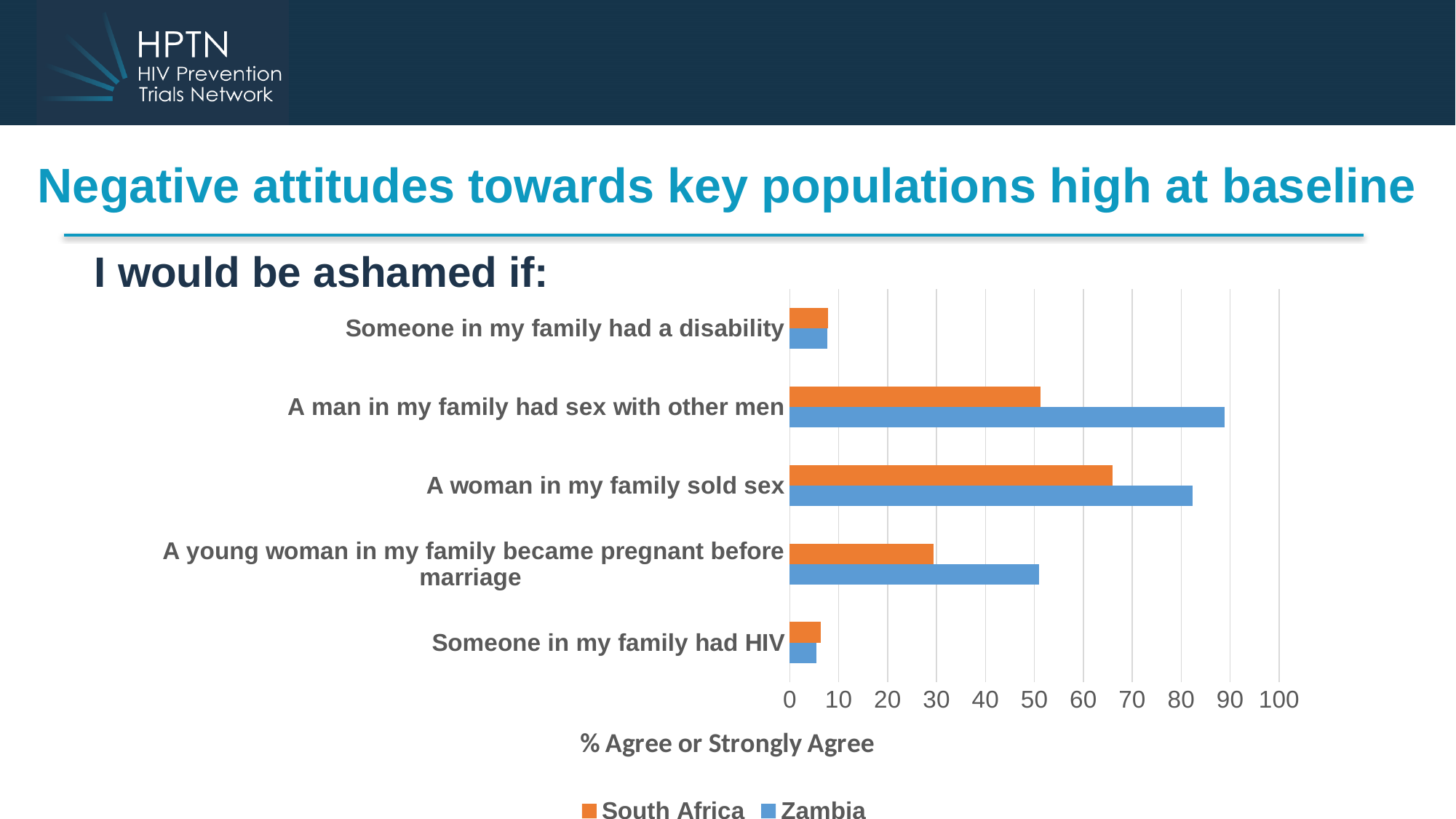
What kind of chart is shown on the slide? bar chart How many categories (statements) are plotted on the chart? 5 How many series does the legend list? 2 Which series does the orange colour represent in the legend? South Africa For 'A woman in my family sold sex', which is larger: the South Africa value or the Zambia value? Zambia Is the Zambia value for 'A man in my family had sex with other men' greater or less than 80? greater Is the South Africa value for 'A woman in my family sold sex' greater or less than 60? greater For which statement is the South Africa value highest? A woman in my family sold sex What is the x-axis label of the chart? % Agree or Strongly Agree Is the South Africa value for 'Someone in my family had a disability' greater or less than 10? less For which statement is the Zambia value highest? A man in my family had sex with other men